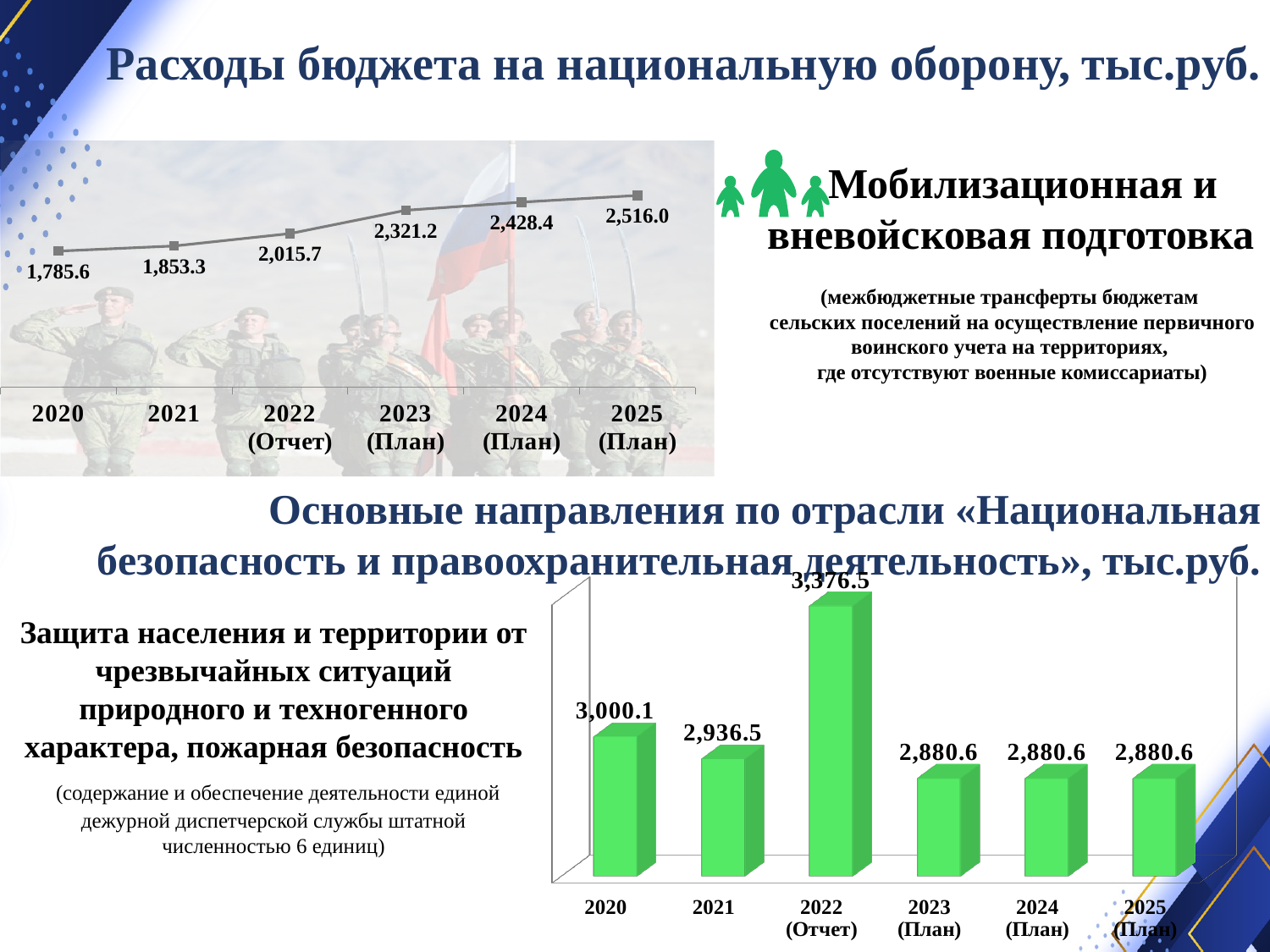
On the top line chart (Расходы бюджета на национальную оборону), what is the difference between the 2025 (План) and 2020 values? 730.4 On the top line chart (Расходы бюджета на национальную оборону), how many years are plotted? 6 On the top line chart (Расходы бюджета на национальную оборону), what is the value for 2025 (План)? 2,516.0 On the top line chart (Расходы бюджета на национальную оборону), which year has the lowest value? 2020 On the bottom bar chart (Национальная безопасность и правоохранительная деятельность), which year has the highest value? 2022 (Отчет) On the bottom bar chart (Национальная безопасность и правоохранительная деятельность), what is the value for 2024 (План)? 2,880.6 On the top line chart (Расходы бюджета на национальную оборону), what is the value for 2020? 1,785.6 On the bottom bar chart (Национальная безопасность и правоохранительная деятельность), which is larger, the value for 2020 or the value for 2021? 2020 On the bottom bar chart (Национальная безопасность и правоохранительная деятельность), what is the difference between the 2022 (Отчет) and 2021 values? 440.0 What kind of chart is the bottom chart (Основные направления по отрасли «Национальная безопасность и правоохранительная деятельность»)? bar chart On the bottom bar chart (Национальная безопасность и правоохранительная деятельность), what is the value for 2022 (Отчет)? 3,376.5 On the top line chart (Расходы бюджета на национальную оборону), do the values rise or fall from 2020 to 2025? rise